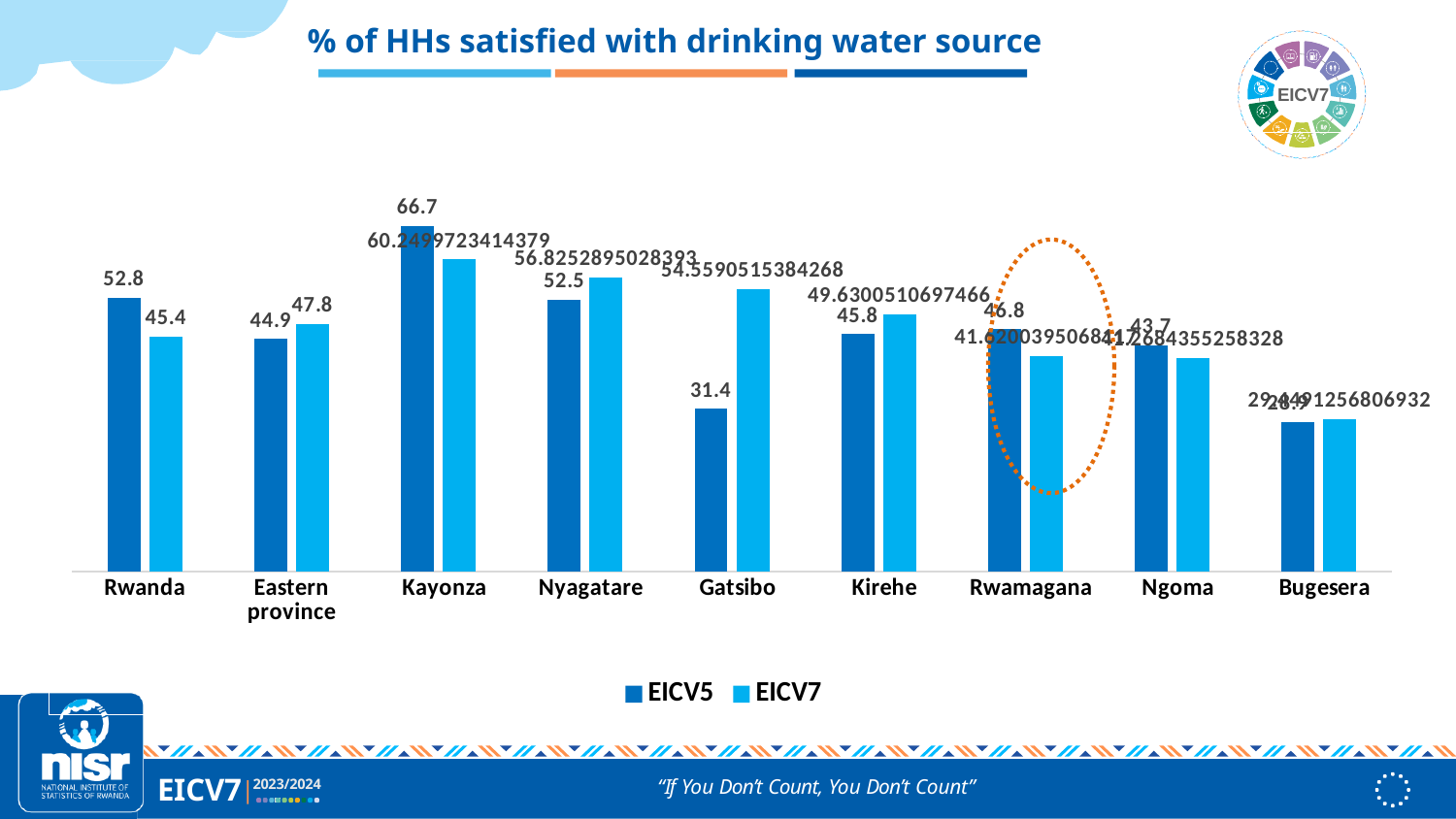
What is the EICV7 value for Rwanda? 45.4 What kind of chart is shown on the slide? Bar chart What is the EICV5 value for Kayonza? 66.7 Which category has the lowest EICV5 value? Bugesera For Gatsibo, which series has the larger value, EICV5 or EICV7? EICV7 What is the difference between the EICV5 and EICV7 values for Rwanda? 7.4 What is the EICV5 value for Gatsibo? 31.4 Which category has the highest EICV5 value? Kayonza How many series does the legend list? 2 What is the EICV7 value for Eastern province? 47.8 What is the EICV5 value for Rwanda? 52.8 How many categories are shown on the x axis? 9